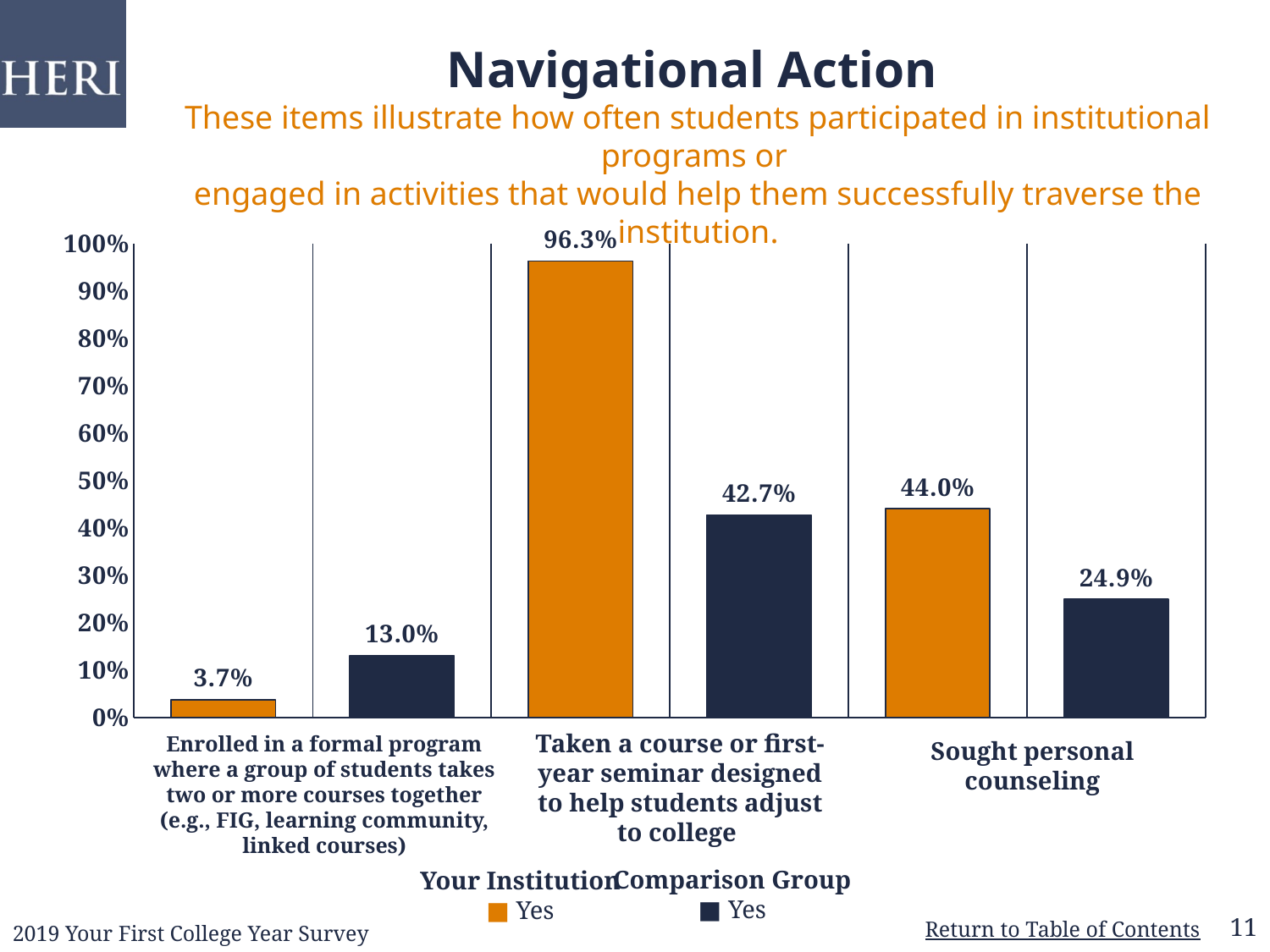
What is the Your Institution value for "Sought personal counseling"? 44.0% What is the Comparison Group value for "Taken a course or first-year seminar designed to help students adjust to college"? 42.7% What is the Your Institution value for "Enrolled in a formal program where a group of students takes two or more courses together"? 3.7% Which category has the lowest Comparison Group value? Enrolled in a formal program where a group of students takes two or more courses together Which category has the highest Your Institution value? Taken a course or first-year seminar designed to help students adjust to college What colour represents the Comparison Group series? Dark navy blue What is the difference between the Your Institution and Comparison Group values for "Taken a course or first-year seminar designed to help students adjust to college"? 53.6% How many series does the legend list? 2 What is the difference between the Comparison Group and Your Institution values for "Enrolled in a formal program where a group of students takes two or more courses together"? 9.3% For "Sought personal counseling", which is larger: the Your Institution value or the Comparison Group value? Your Institution What kind of chart is shown on the slide? Bar chart How many categories are shown on the x axis? 3